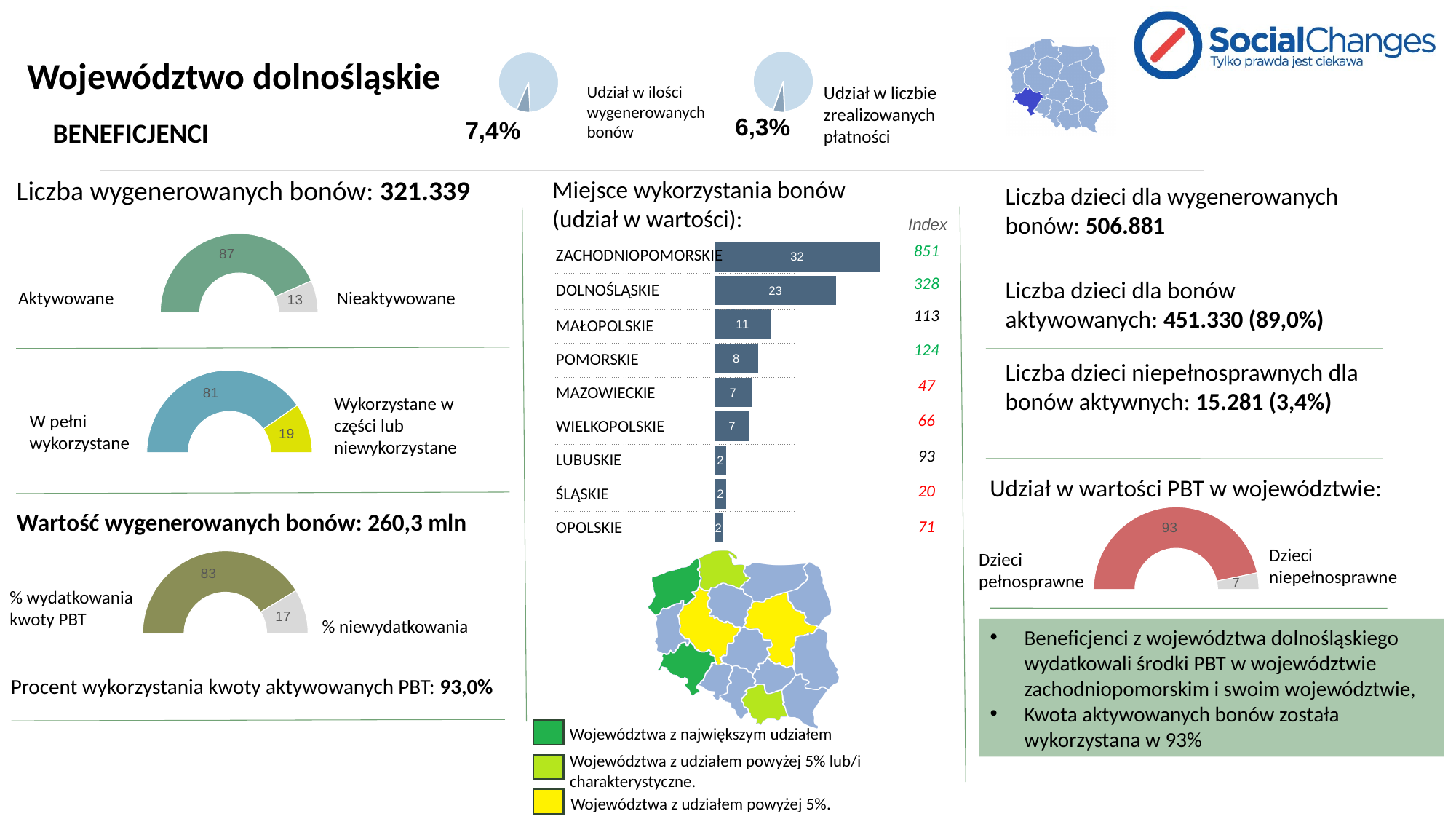
In the 'Miejsce wykorzystania bonów (udział w wartości)' bar chart, what is the Index value shown for ZACHODNIOPOMORSKIE? 851 In the gauge chart under 'Liczba wygenerowanych bonów', what is the value for Aktywowane? 87 What kind of chart is 'Miejsce wykorzystania bonów (udział w wartości)'? bar chart In the gauge chart under 'Liczba wygenerowanych bonów', what is the value for Nieaktywowane? 13 In the 'Udział w wartości PBT w województwie' gauge chart, what is the value for 'Dzieci niepełnosprawne'? 7 In the 'Miejsce wykorzystania bonów (udział w wartości)' bar chart, which is larger: the value for MAŁOPOLSKIE or the value for POMORSKIE? MAŁOPOLSKIE In the 'Miejsce wykorzystania bonów (udział w wartości)' bar chart, what is the value for LUBUSKIE? 2 In the 'Miejsce wykorzystania bonów (udział w wartości)' bar chart, what is the difference between the values for ZACHODNIOPOMORSKIE and DOLNOŚLĄSKIE? 9 In the 'Miejsce wykorzystania bonów (udział w wartości)' bar chart, what is the value for DOLNOŚLĄSKIE? 23 How many voivodeships are listed in the 'Miejsce wykorzystania bonów (udział w wartości)' bar chart? 9 In the gauge chart showing 'W pełni wykorzystane' versus 'Wykorzystane w części lub niewykorzystane', what is the value for 'Wykorzystane w części lub niewykorzystane'? 19 In the 'Miejsce wykorzystania bonów (udział w wartości)' bar chart, which voivodeship has the highest value? ZACHODNIOPOMORSKIE